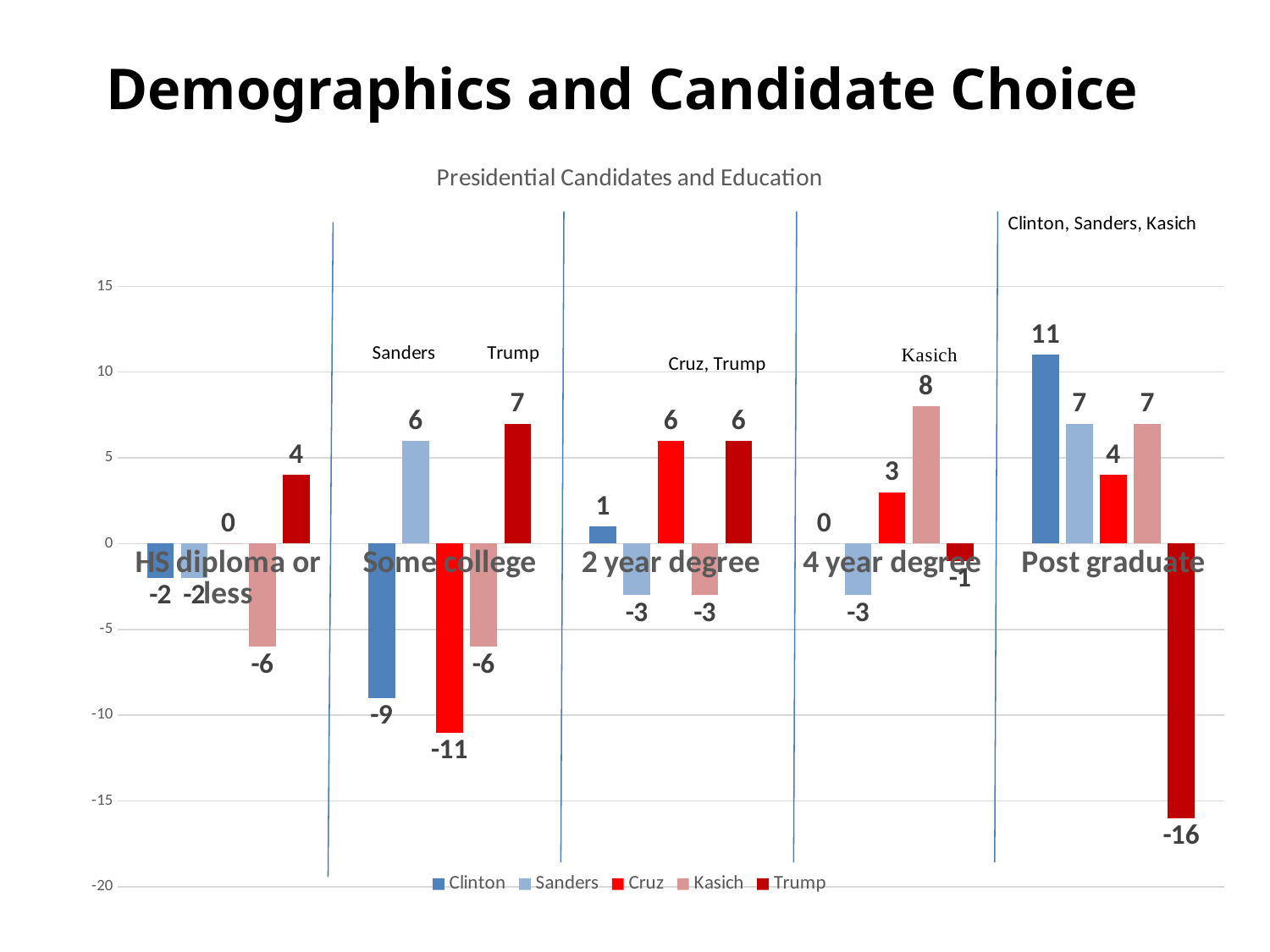
What kind of chart is shown on the slide? Bar chart What is the title of the chart? Presidential Candidates and Education Which is larger in the 4 year degree category: Kasich's value or Cruz's value? Kasich's value How many education categories are shown on the x axis? 5 Which candidate has the lowest value in the Some college category? Cruz How many series does the legend list? 5 What is the value for Trump in the Post graduate category? -16 What is the value for Clinton in the Some college category? -9 Which candidate has the highest value in the Post graduate category? Clinton What is the value for Kasich in the 4 year degree category? 8 What is the difference between Clinton's value and Trump's value in the Post graduate category? 27 What is the value for Cruz in the Some college category? -11